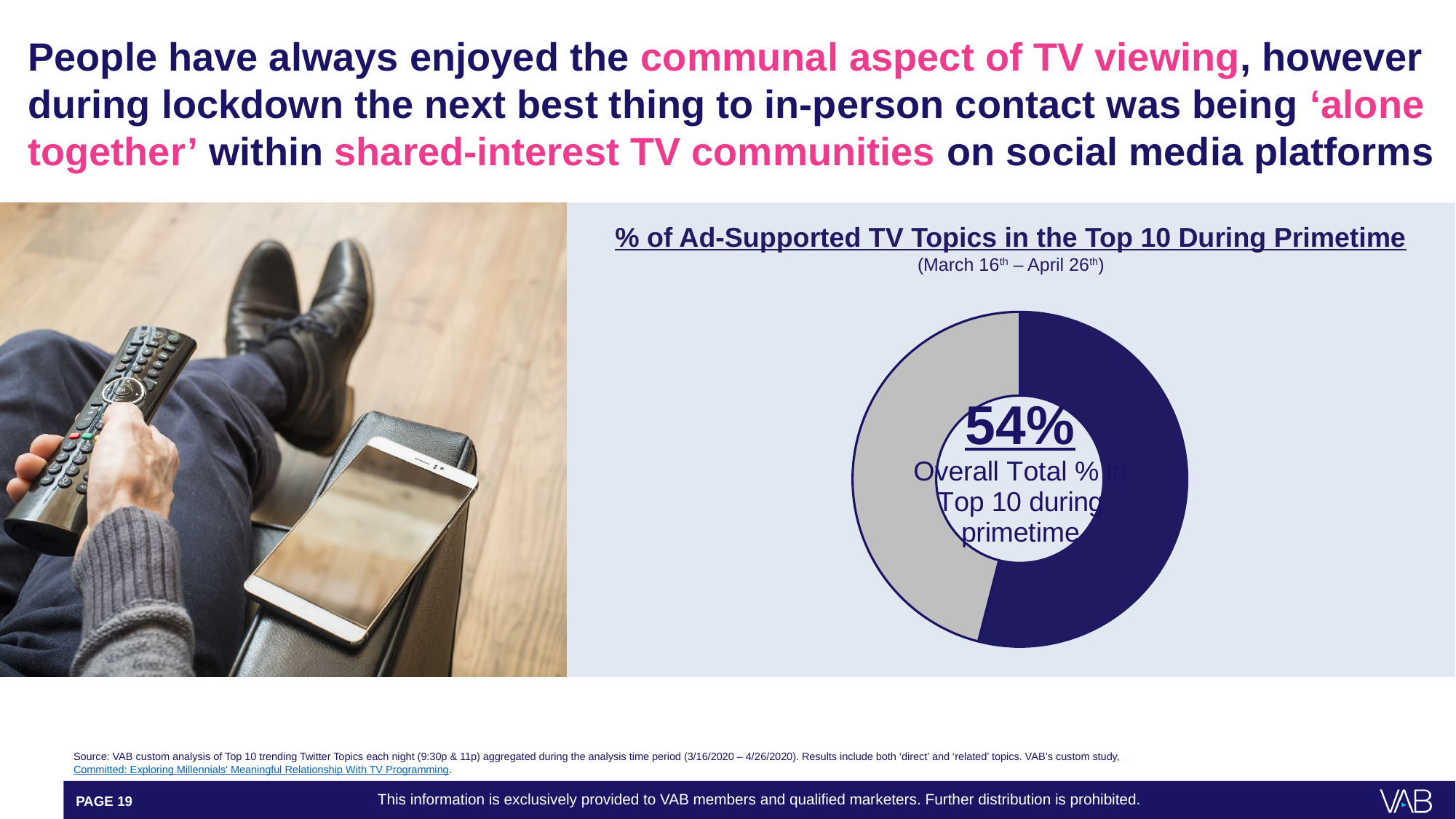
What date range does the chart cover? March 16th – April 26th What share of the pie does the grey slice represent? 46% What is the title of the chart? % of Ad-Supported TV Topics in the Top 10 During Primetime Is the value shown in the centre of the chart greater or less than 50%? greater Which slice of the pie chart is larger, the dark blue slice or the grey slice? the dark blue slice What is the overall total % of ad-supported TV topics in the Top 10 during primetime shown in the chart? 54% Which slice is the largest in the pie chart? the dark blue slice (54%) What share of the pie does the dark blue slice represent? 54% How many slices does the pie chart have? 2 What type of chart is shown on the slide? pie chart (donut)